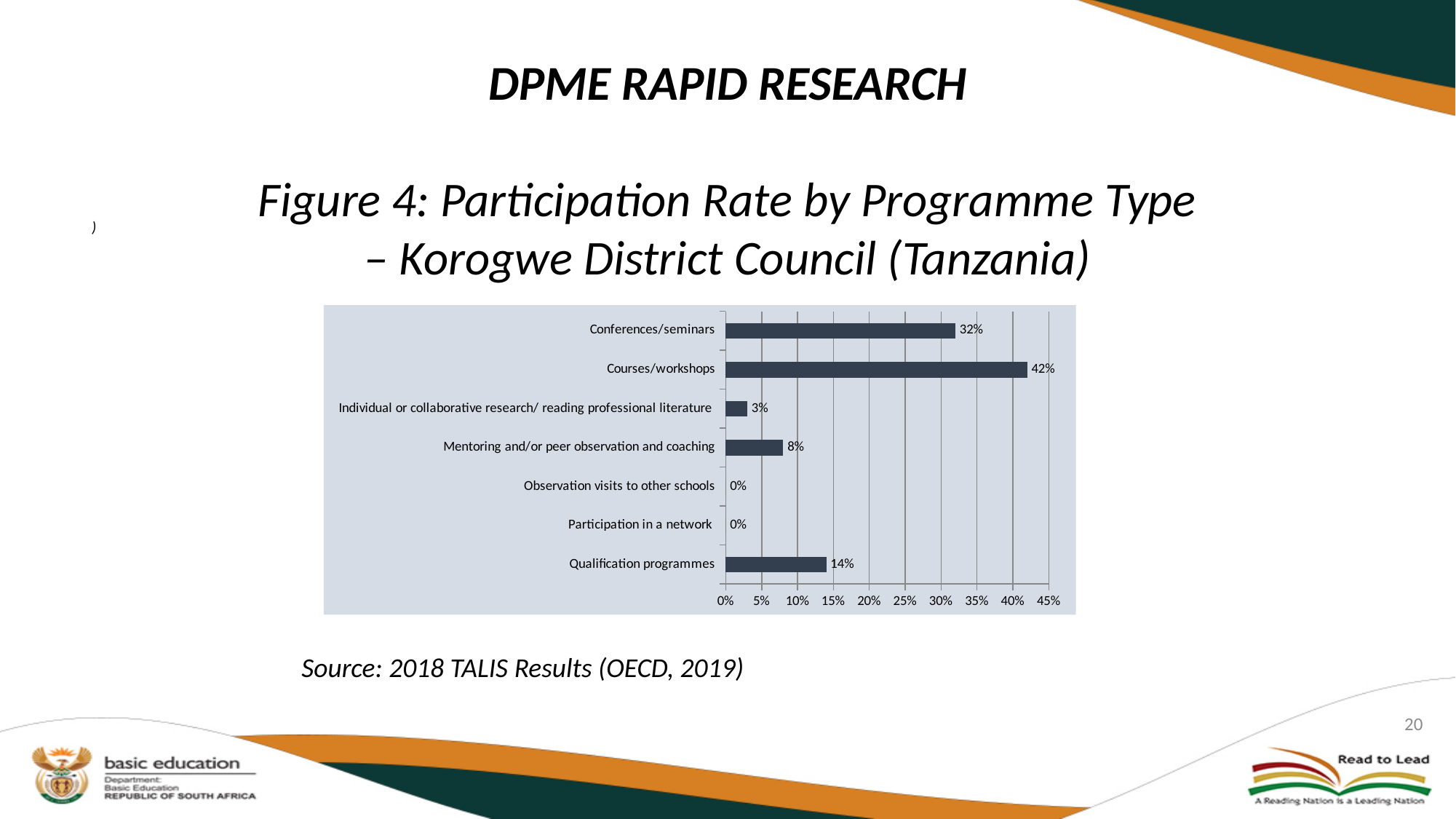
What is the participation rate for Qualification programmes? 14% How many programme types have a participation rate of 0%? 2 What is the participation rate for Mentoring and/or peer observation and coaching? 8% What is the participation rate for Conferences/seminars? 32% What is the maximum value shown on the horizontal axis of the chart? 45% Which has a higher participation rate, Qualification programmes or Mentoring and/or peer observation and coaching? Qualification programmes How many programme types are shown in the chart? 7 What kind of chart is shown on the slide? Bar chart Which programme type has the highest participation rate? Courses/workshops What is the participation rate for Individual or collaborative research/ reading professional literature? 3% What is the participation rate for Courses/workshops? 42% What is the difference in participation rate between Courses/workshops and Conferences/seminars? 10%